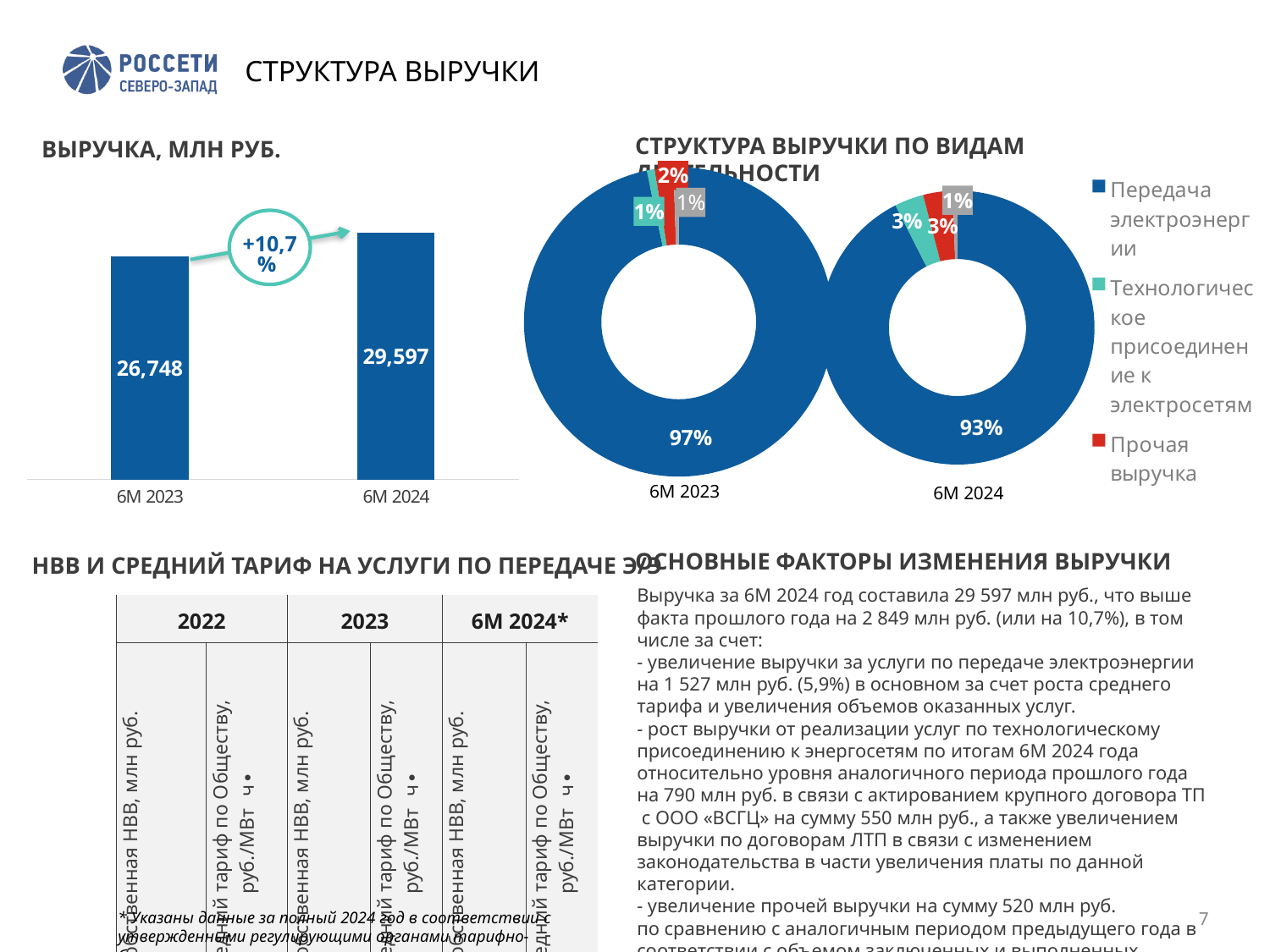
In the chart titled 'ВЫРУЧКА, МЛН РУБ.', what is the value for 6M 2023? 26,748 What kind of chart is the one titled 'ВЫРУЧКА, МЛН РУБ.'? Bar chart In the chart titled 'СТРУКТУРА ВЫРУЧКИ ПО ВИДАМ ДЕЯТЕЛЬНОСТИ', what share does 'Передача электроэнергии' have in 6M 2023? 97% In the chart titled 'ВЫРУЧКА, МЛН РУБ.', which period has the higher value? 6M 2024 In the chart titled 'СТРУКТУРА ВЫРУЧКИ ПО ВИДАМ ДЕЯТЕЛЬНОСТИ', what share does 'Передача электроэнергии' have in 6M 2024? 93% What kind of chart is the one titled 'СТРУКТУРА ВЫРУЧКИ ПО ВИДАМ ДЕЯТЕЛЬНОСТИ'? Doughnut chart In the chart titled 'ВЫРУЧКА, МЛН РУБ.', how many bars are plotted? 2 In the chart titled 'ВЫРУЧКА, МЛН РУБ.', what percentage change is shown between 6M 2023 and 6M 2024? +10,7% In the chart titled 'ВЫРУЧКА, МЛН РУБ.', what is the difference between the 6M 2024 and 6M 2023 values? 2,849 In the chart titled 'СТРУКТУРА ВЫРУЧКИ ПО ВИДАМ ДЕЯТЕЛЬНОСТИ', how many entries does the legend list? 3 In the chart titled 'СТРУКТУРА ВЫРУЧКИ ПО ВИДАМ ДЕЯТЕЛЬНОСТИ', what share does 'Технологическое присоединение к электросетям' have in 6M 2024? 3% In the chart titled 'ВЫРУЧКА, МЛН РУБ.', what is the value for 6M 2024? 29,597